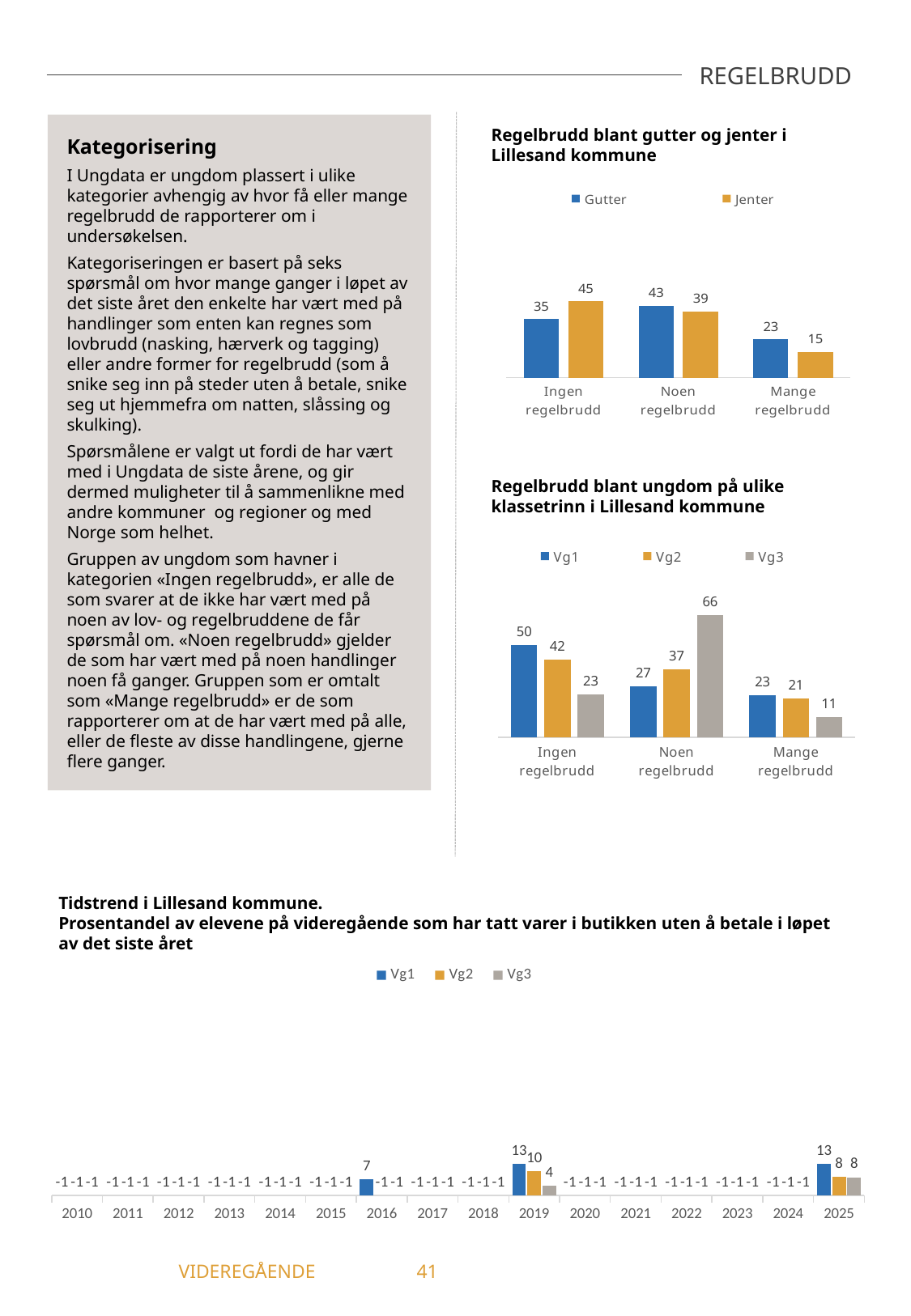
In the chart 'Regelbrudd blant gutter og jenter i Lillesand kommune', what is the value for Jenter in the 'Ingen regelbrudd' category? 45 In the chart 'Regelbrudd blant gutter og jenter i Lillesand kommune', which series has the higher value for 'Ingen regelbrudd', Gutter or Jenter? Jenter How many categories are shown on the x axis of the chart 'Regelbrudd blant ungdom på ulike klassetrinn i Lillesand kommune'? 3 In the chart 'Regelbrudd blant ungdom på ulike klassetrinn i Lillesand kommune', what is the difference between Vg1 and Vg2 in the 'Noen regelbrudd' category? 10 In the chart 'Regelbrudd blant ungdom på ulike klassetrinn i Lillesand kommune', what is the value for Vg3 in the 'Noen regelbrudd' category? 66 How many series does the legend list in the chart 'Regelbrudd blant gutter og jenter i Lillesand kommune'? 2 In the chart 'Regelbrudd blant ungdom på ulike klassetrinn i Lillesand kommune', which series has the lowest value in the 'Mange regelbrudd' category? Vg3 What kind of chart is 'Tidstrend i Lillesand kommune'? Bar chart In the chart 'Tidstrend i Lillesand kommune', what is the value for Vg1 in 2019? 13 In the chart 'Regelbrudd blant gutter og jenter i Lillesand kommune', what is the value for Gutter in the 'Noen regelbrudd' category? 43 In the chart 'Regelbrudd blant gutter og jenter i Lillesand kommune', what is the difference between Gutter and Jenter in the 'Mange regelbrudd' category? 8 In the chart 'Regelbrudd blant ungdom på ulike klassetrinn i Lillesand kommune', which series has the highest value in the 'Ingen regelbrudd' category? Vg1